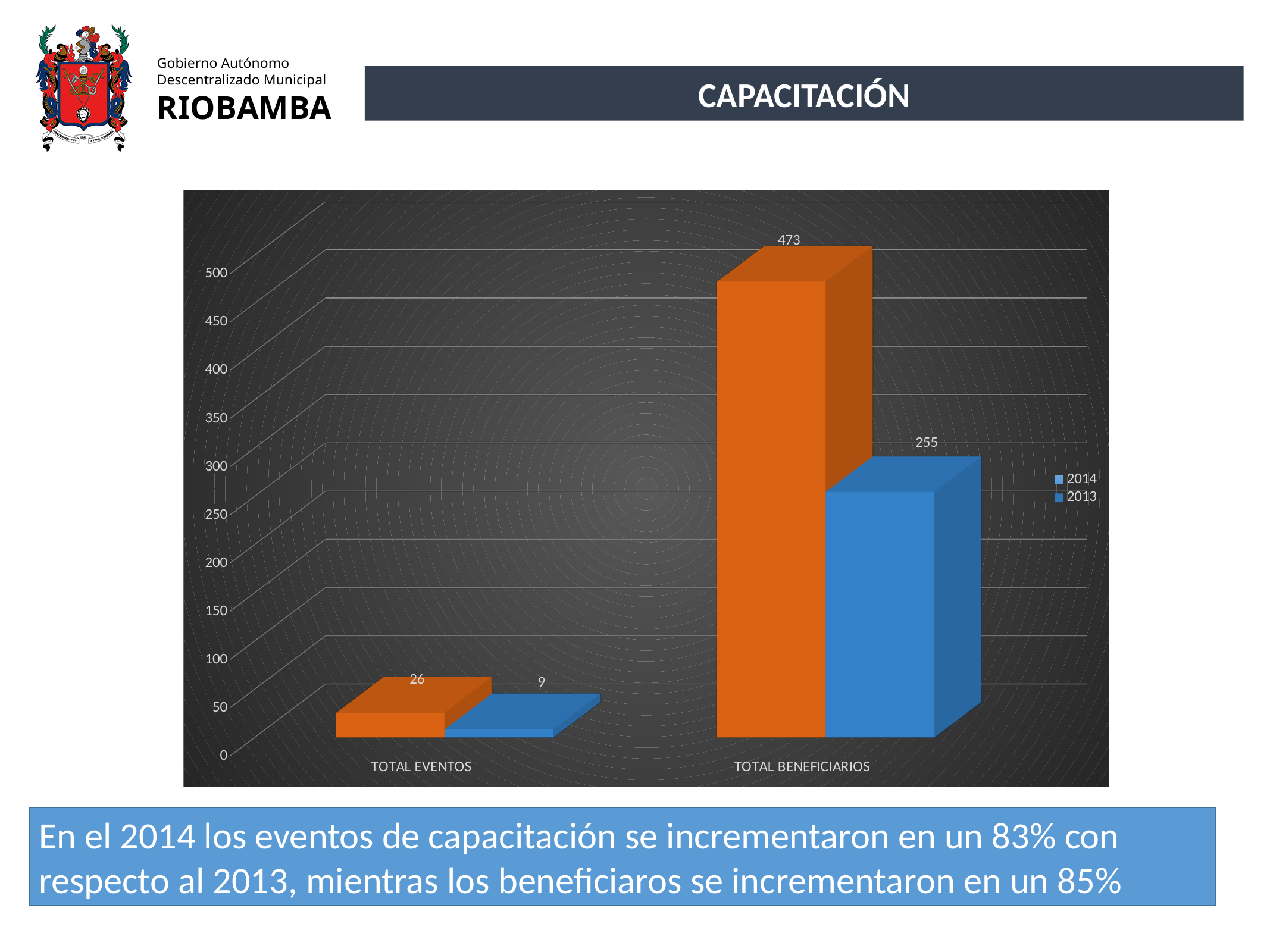
What is the difference between the 2014 and 2013 values for TOTAL EVENTOS? 17 How many series does the chart legend list? 2 What is the value for 2013 in the TOTAL BENEFICIARIOS category? 255 Which is larger for TOTAL BENEFICIARIOS, the 2014 value or the 2013 value? 2014 What is the value for 2013 in the TOTAL EVENTOS category? 9 Which bar has the highest value in the chart? 2014, TOTAL BENEFICIARIOS Which bar has the lowest value in the chart? 2013, TOTAL EVENTOS What is the value for 2014 in the TOTAL BENEFICIARIOS category? 473 What is the value for 2014 in the TOTAL EVENTOS category? 26 What is the difference between the 2014 and 2013 values for TOTAL BENEFICIARIOS? 218 What kind of chart is shown on the slide? Bar chart How many categories are shown on the x axis of the chart? 2